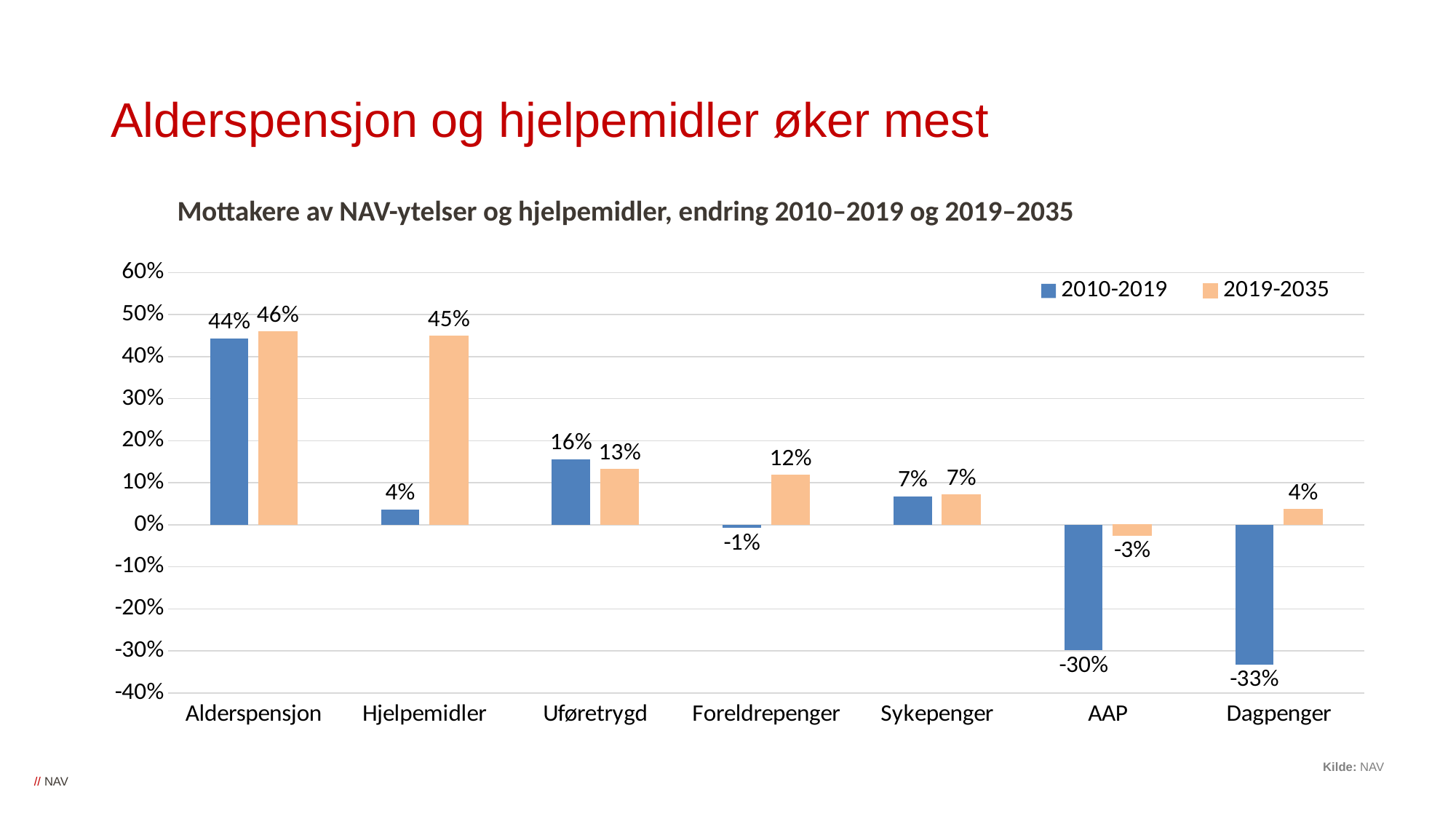
How many categories are shown on the x axis? 7 What is the difference between the 2010-2019 and 2019-2035 values for Hjelpemidler? 41 percentage points What kind of chart is shown on the slide? Bar chart Which is larger for Uføretrygd: the 2010-2019 value or the 2019-2035 value? 2010-2019 Which category has the highest value in the 2019-2035 series? Alderspensjon What is the value for Hjelpemidler in the 2019-2035 series? 45% What is the title of the chart? Mottakere av NAV-ytelser og hjelpemidler, endring 2010–2019 og 2019–2035 Which colour represents the 2019-2035 series? Orange How many series does the legend list? 2 What is the value for Foreldrepenger in the 2019-2035 series? 12% Which category has the lowest value in the 2010-2019 series? Dagpenger What is the value for AAP in the 2010-2019 series? -30%